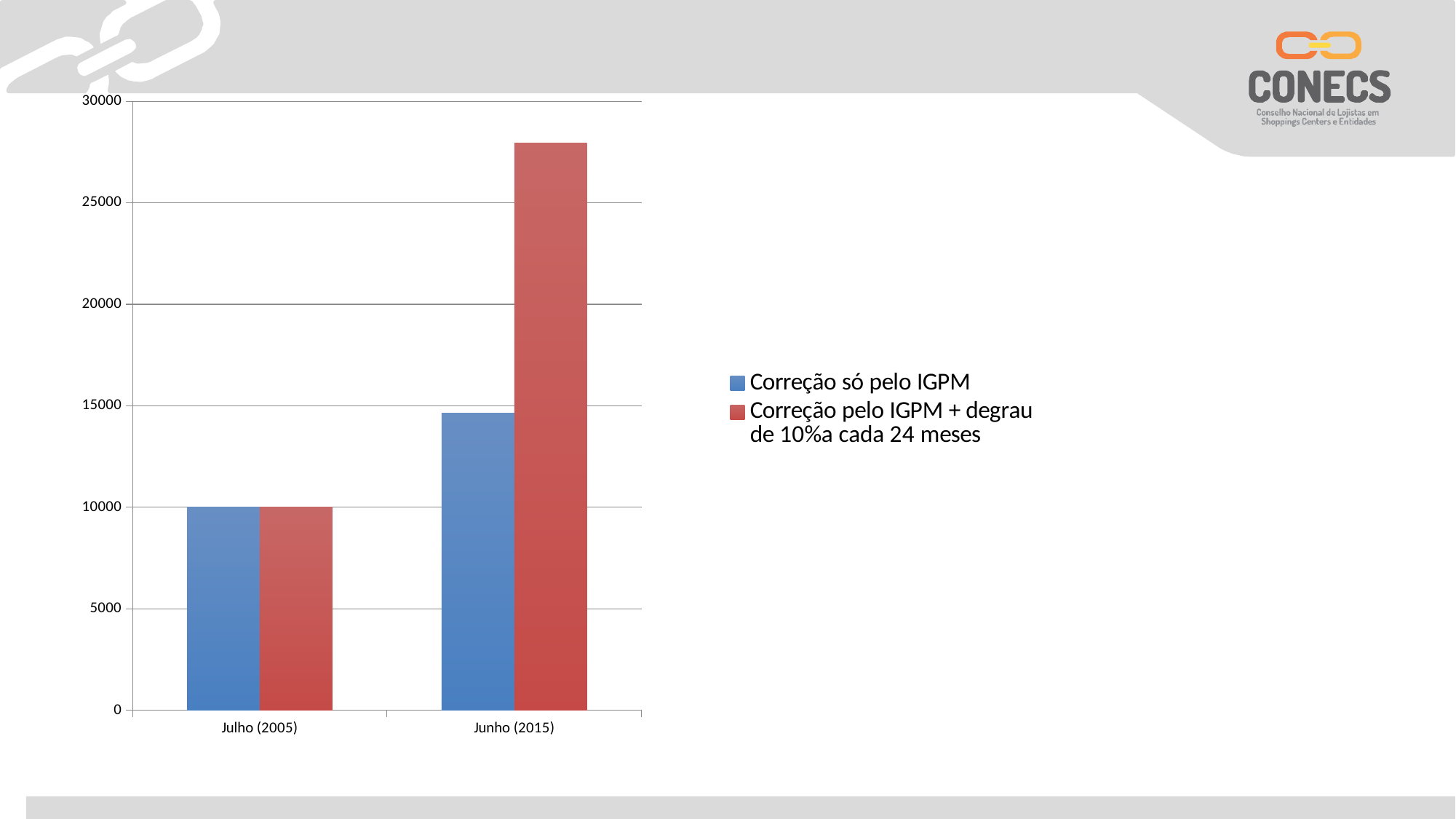
What kind of chart is shown on the slide? bar chart Which series has the higher value in Junho (2015)? Correção pelo IGPM + degrau de 10%a cada 24 meses How many categories are shown on the x axis? 2 Is the value for 'Correção só pelo IGPM' in Junho (2015) greater or less than 10000? greater What colour represents the series 'Correção só pelo IGPM'? blue What is the value for 'Correção pelo IGPM + degrau de 10%a cada 24 meses' in Julho (2005)? 10000 Which category has the highest value for 'Correção pelo IGPM + degrau de 10%a cada 24 meses'? Junho (2015) How many series does the legend list? 2 What is the value for 'Correção só pelo IGPM' in Julho (2005)? 10000 Is the value for 'Correção pelo IGPM + degrau de 10%a cada 24 meses' in Junho (2015) greater or less than 25000? greater Do the values for 'Correção só pelo IGPM' rise or fall from Julho (2005) to Junho (2015)? rise Is the value for 'Correção só pelo IGPM' in Junho (2015) greater or less than 15000? less